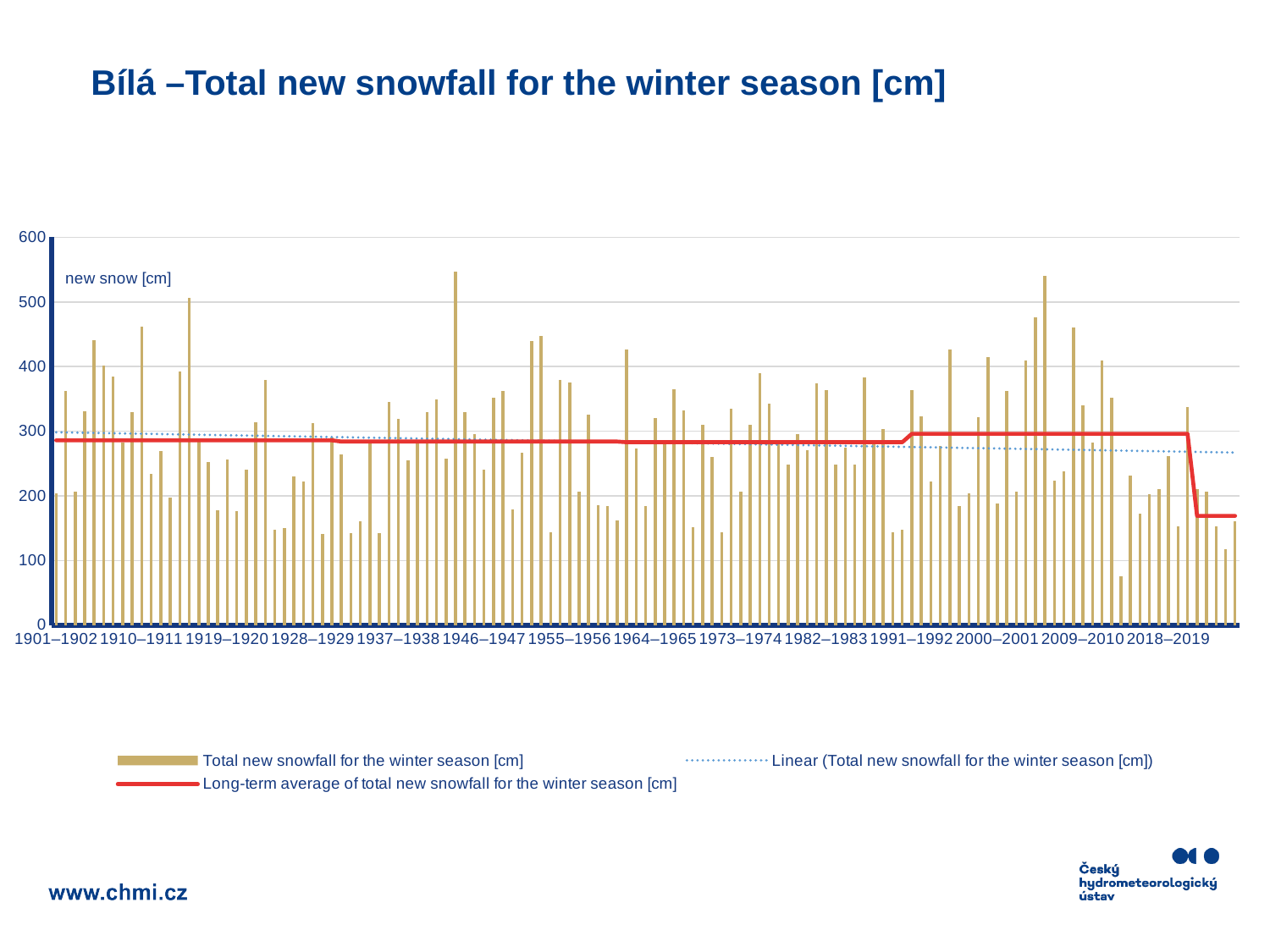
Is the value for 1901–1902 greater or less than 300? less What label is printed inside the plot area near the top of the y axis? new snow [cm] What is the highest value shown on the y axis? 600 What is the first x-axis label shown on the chart? 1901–1902 Does the dotted linear trend line rise or fall from left to right across the x axis? fall What is the title of the chart? Bílá –Total new snowfall for the winter season [cm] Does the red long-term average line end higher or lower than it starts? lower Is the tallest bar in the chart greater or less than 500? greater Is the value for 2018–2019 greater or less than 400? less What kind of chart is shown on the slide? combination bar and line chart How many series does the legend list? 3